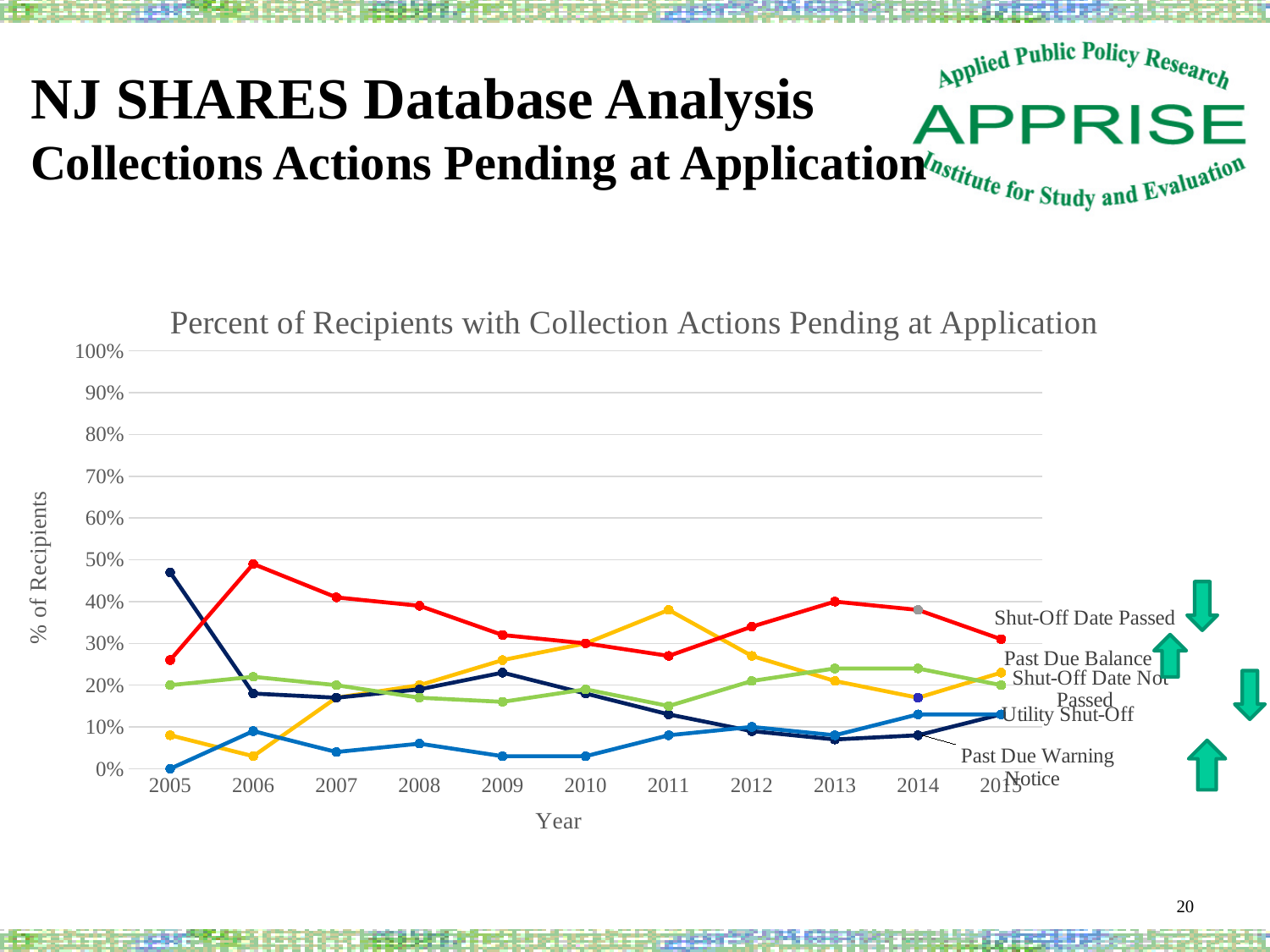
Which series has the highest value in 2006? Shut-Off Date Passed In 2005, which is larger: Past Due Warning Notice or Shut-Off Date Passed? Past Due Warning Notice Does the Past Due Warning Notice series rise or fall overall from 2005 to 2015? fall What is the label on the vertical axis? % of Recipients Is the value for Utility Shut-Off in 2009 greater or less than 10%? less Which series has the lowest value in 2005? Utility Shut-Off What is the title of the chart? Percent of Recipients with Collection Actions Pending at Application What kind of chart is shown on the slide? line chart How many data series are plotted on the chart? 5 What is the value for Utility Shut-Off in 2005? 0% Is the value for Shut-Off Date Passed in 2006 greater or less than 40%? greater How many years are shown along the x axis? 11